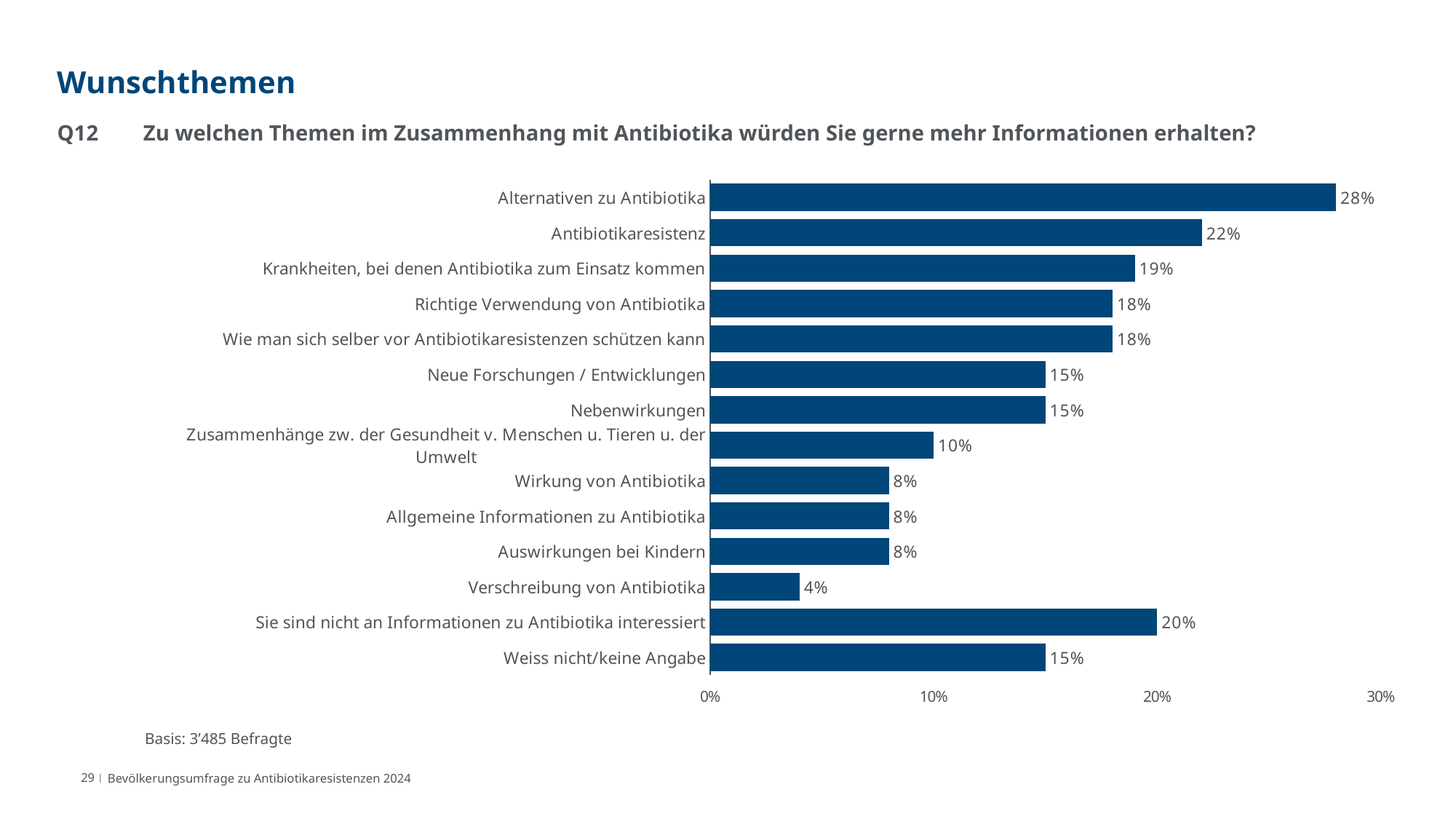
What is the value for "Verschreibung von Antibiotika"? 4% Which category has the lowest value? Verschreibung von Antibiotika Is the value for "Krankheiten, bei denen Antibiotika zum Einsatz kommen" greater or less than 10%? greater What is the difference between the values for "Alternativen zu Antibiotika" and "Antibiotikaresistenz"? 6% What is the basis (number of respondents) stated below the chart? 3'485 Befragte What is the value for "Zusammenhänge zw. der Gesundheit v. Menschen u. Tieren u. der Umwelt"? 10% What is the value for "Sie sind nicht an Informationen zu Antibiotika interessiert"? 20% Which is larger: the value for "Antibiotikaresistenz" or the value for "Sie sind nicht an Informationen zu Antibiotika interessiert"? Antibiotikaresistenz What kind of chart is shown on the slide? Bar chart How many categories are shown in the chart? 14 Which category has the highest value? Alternativen zu Antibiotika What is the value for "Alternativen zu Antibiotika"? 28%